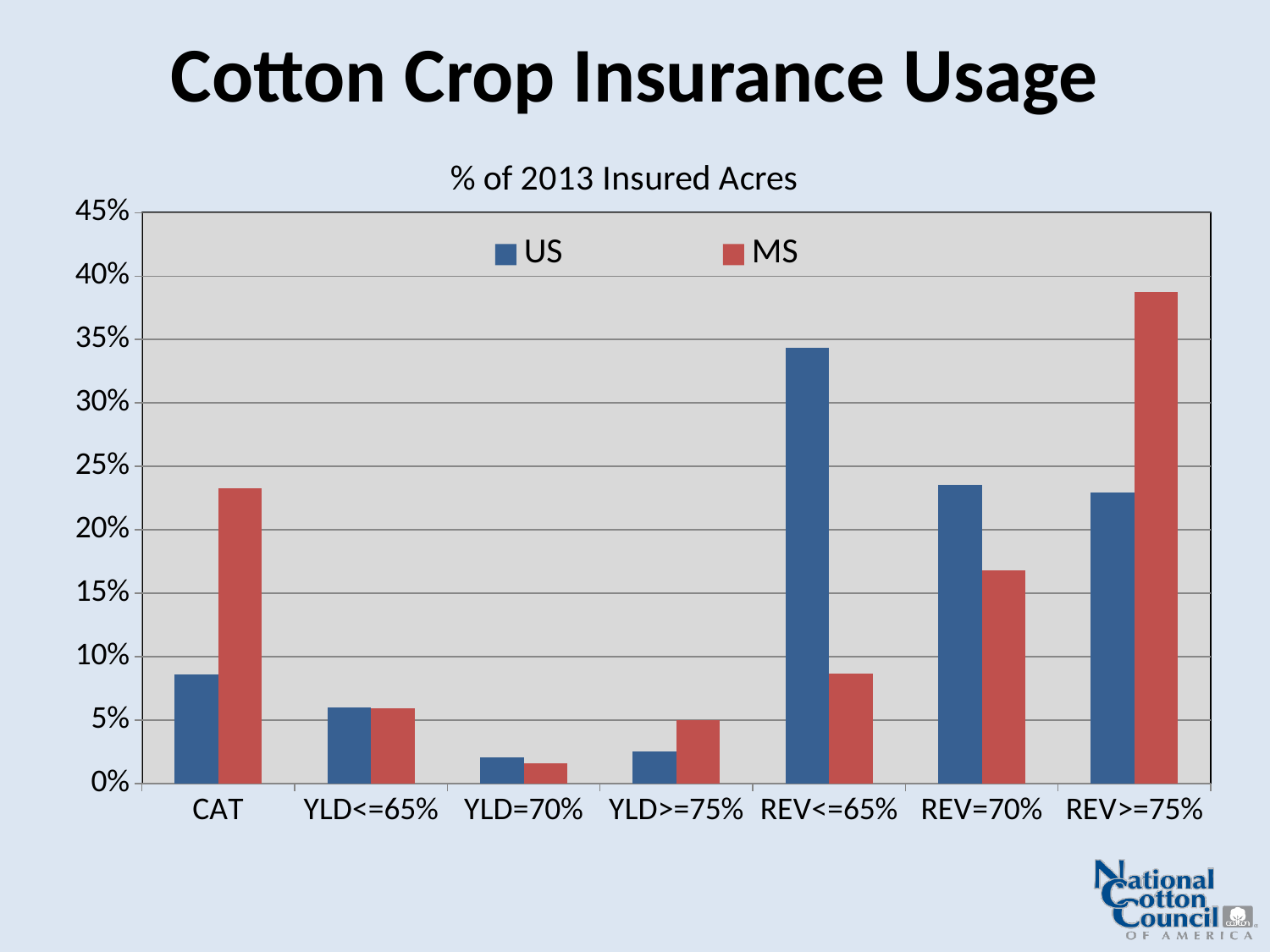
Which category has the lowest value for the MS series? YLD=70% Which category has the highest value for the US series? REV<=65% How many categories are shown on the x axis? 7 Is the MS value for REV>=75% greater or less than 35%? greater Is the US value for REV<=65% greater or less than 30%? greater Which category has the highest value for the MS series? REV>=75% For the REV<=65% category, which series has the larger value, US or MS? US For the REV=70% category, which series has the larger value, US or MS? US For the CAT category, which series has the larger value, US or MS? MS How many series does the legend list? 2 What is the subtitle shown above the chart? % of 2013 Insured Acres What kind of chart is shown on the slide? bar chart